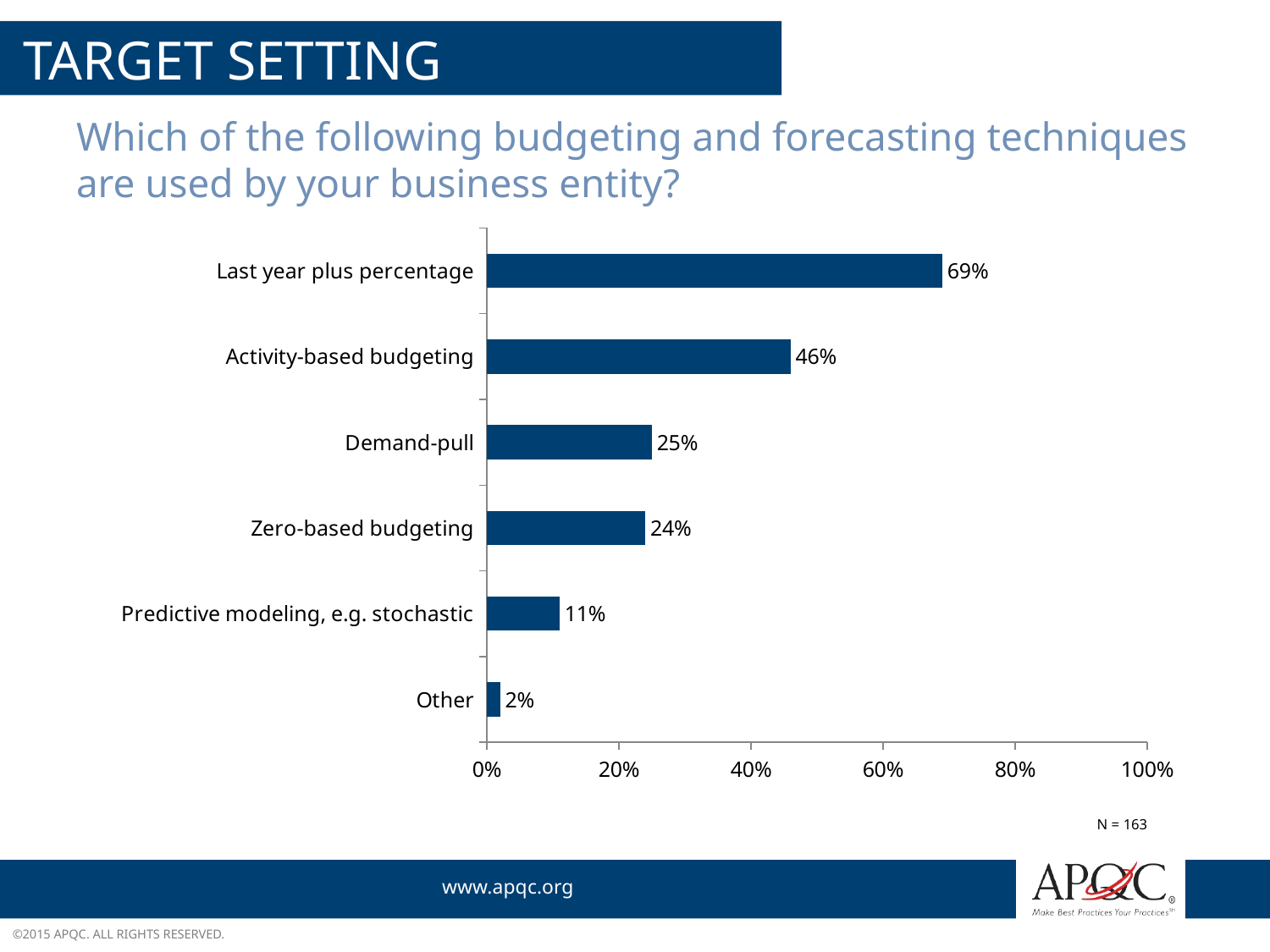
What is the difference between last year plus percentage and activity-based budgeting? 23% What percentage of respondents use last year plus percentage? 69% What is the difference between demand-pull and zero-based budgeting? 1% What percentage is shown for predictive modeling, e.g. stochastic? 11% How many categories are shown in the chart? 6 Which budgeting and forecasting technique has the highest percentage? Last year plus percentage Is the value for last year plus percentage greater or less than 60%? greater What is the value for the Other category? 2% What is the value for activity-based budgeting? 46% What kind of chart is shown on the slide? Bar chart Which is larger, activity-based budgeting or demand-pull? Activity-based budgeting Which category has the lowest value? Other